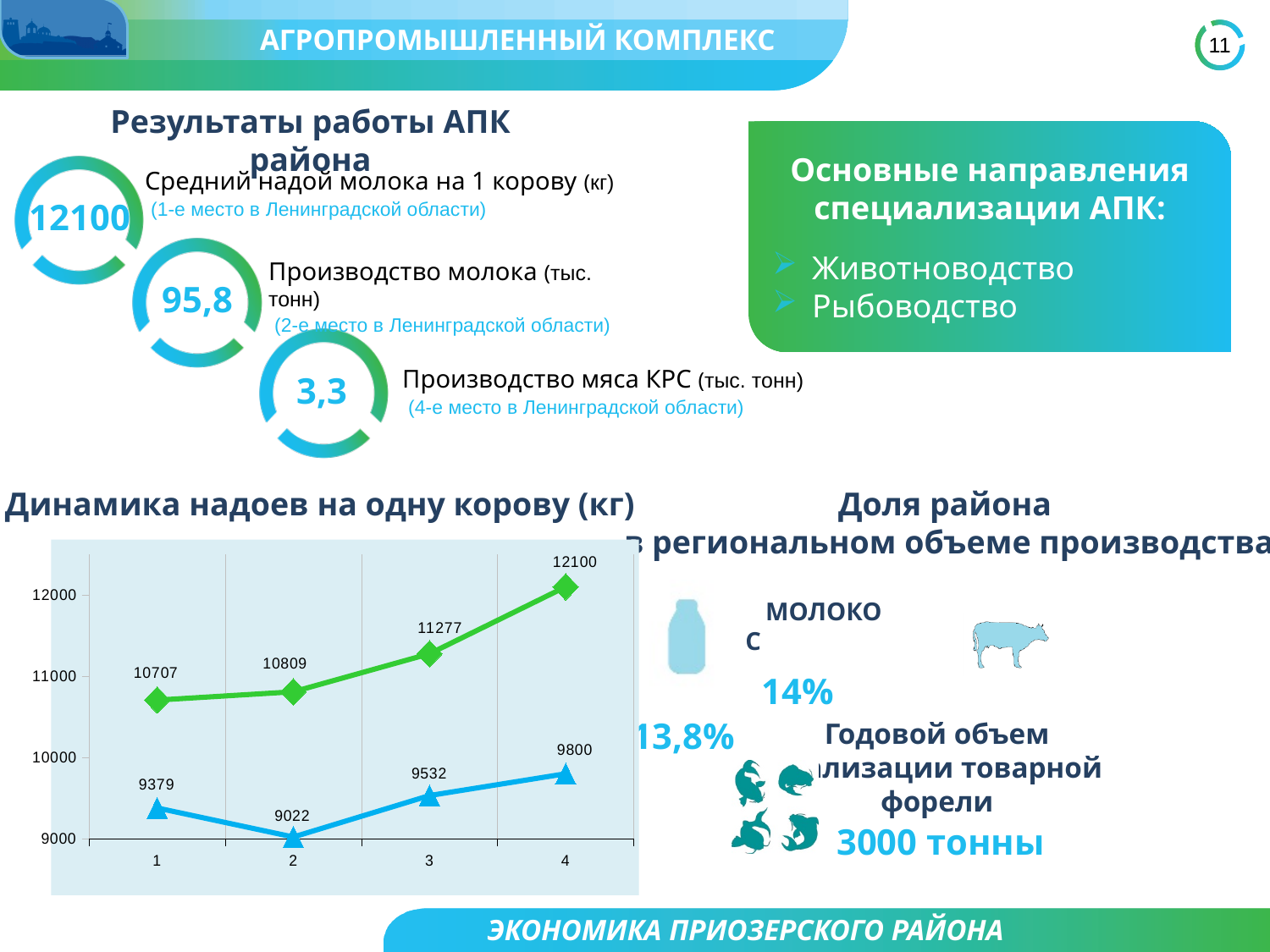
In the chart 'Динамика надоев на одну корову (кг)', which line has the larger value at point 4, the green or the blue? green In the chart 'Динамика надоев на одну корову (кг)', does the green line generally rise or fall from point 1 to point 4? rise In the chart 'Динамика надоев на одну корову (кг)', what is the value of the green line at point 1? 10707 What kind of chart is shown under the title 'Динамика надоев на одну корову (кг)'? line chart In the chart 'Динамика надоев на одну корову (кг)', at which x-axis point does the blue line have its lowest value? 2 In the chart 'Динамика надоев на одну корову (кг)', what is the value of the green line at point 4? 12100 In the chart 'Динамика надоев на одну корову (кг)', what is the difference between the green line's value at point 4 and at point 3? 823 In the chart 'Динамика надоев на одну корову (кг)', at which x-axis point does the green line reach its highest value? 4 How many x-axis points are plotted in the chart 'Динамика надоев на одну корову (кг)'? 4 In the chart 'Динамика надоев на одну корову (кг)', what is the value of the blue line at point 2? 9022 In the chart 'Динамика надоев на одну корову (кг)', what is the value of the blue line at point 3? 9532 In the chart 'Динамика надоев на одну корову (кг)', what is the difference between the green and blue line values at point 1? 1328